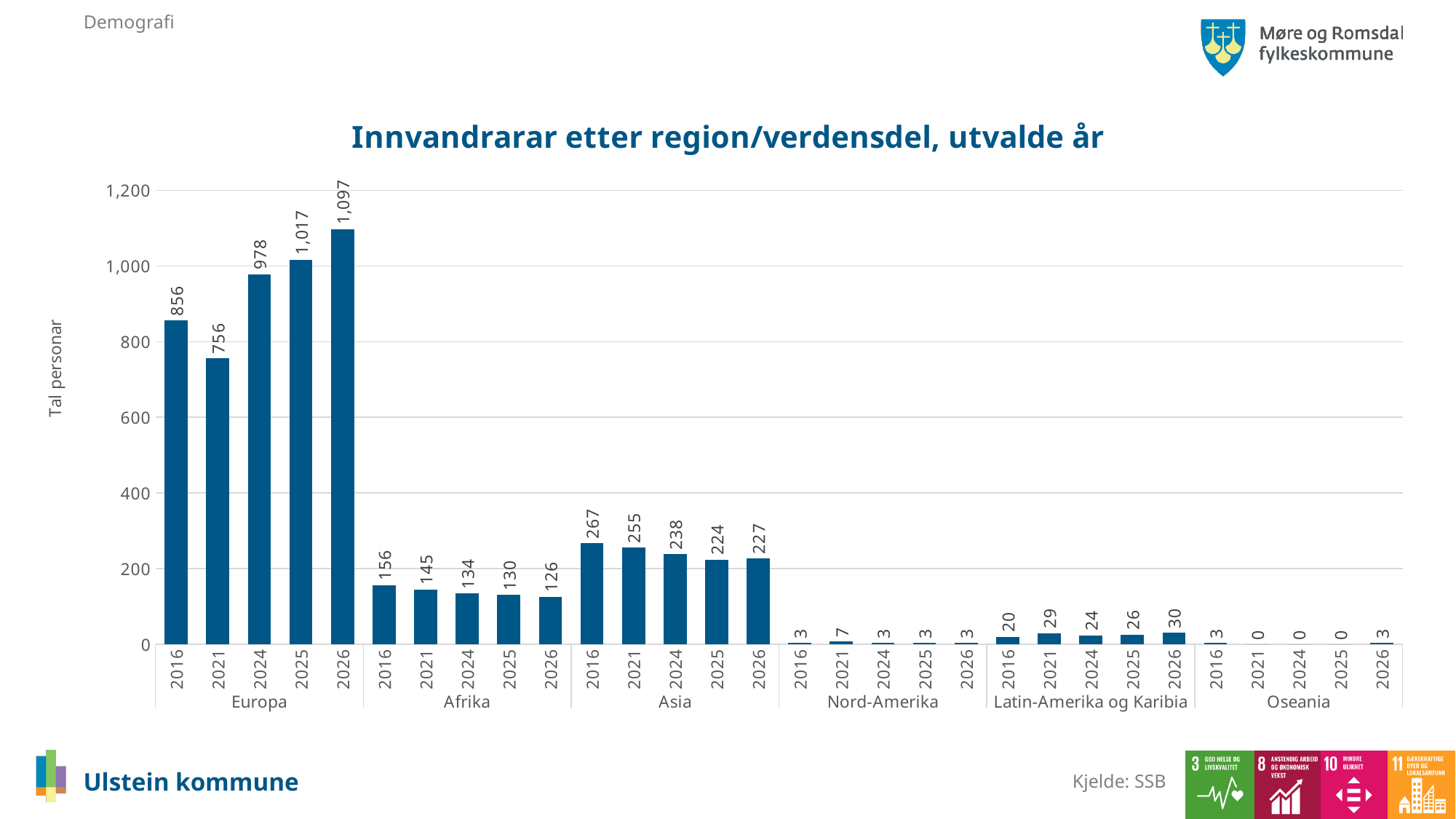
Do the values for Afrika rise or fall from 2016 to 2026? fall What is the value for Europa in 2026? 1,097 Is the value for Europa in 2024 greater or less than 1,000? less Which is larger: Afrika in 2016 or Asia in 2026? Asia in 2026 Which year has the lowest value for Europa? 2021 What is the value for Latin-Amerika og Karibia in 2026? 30 Which region has the highest value in 2026? Europa What is the value for Asia in 2016? 267 What is the difference between the Europa values for 2026 and 2016? 241 What is the value for Afrika in 2021? 145 How many regions are shown on the x axis? 6 What kind of chart is shown? bar chart